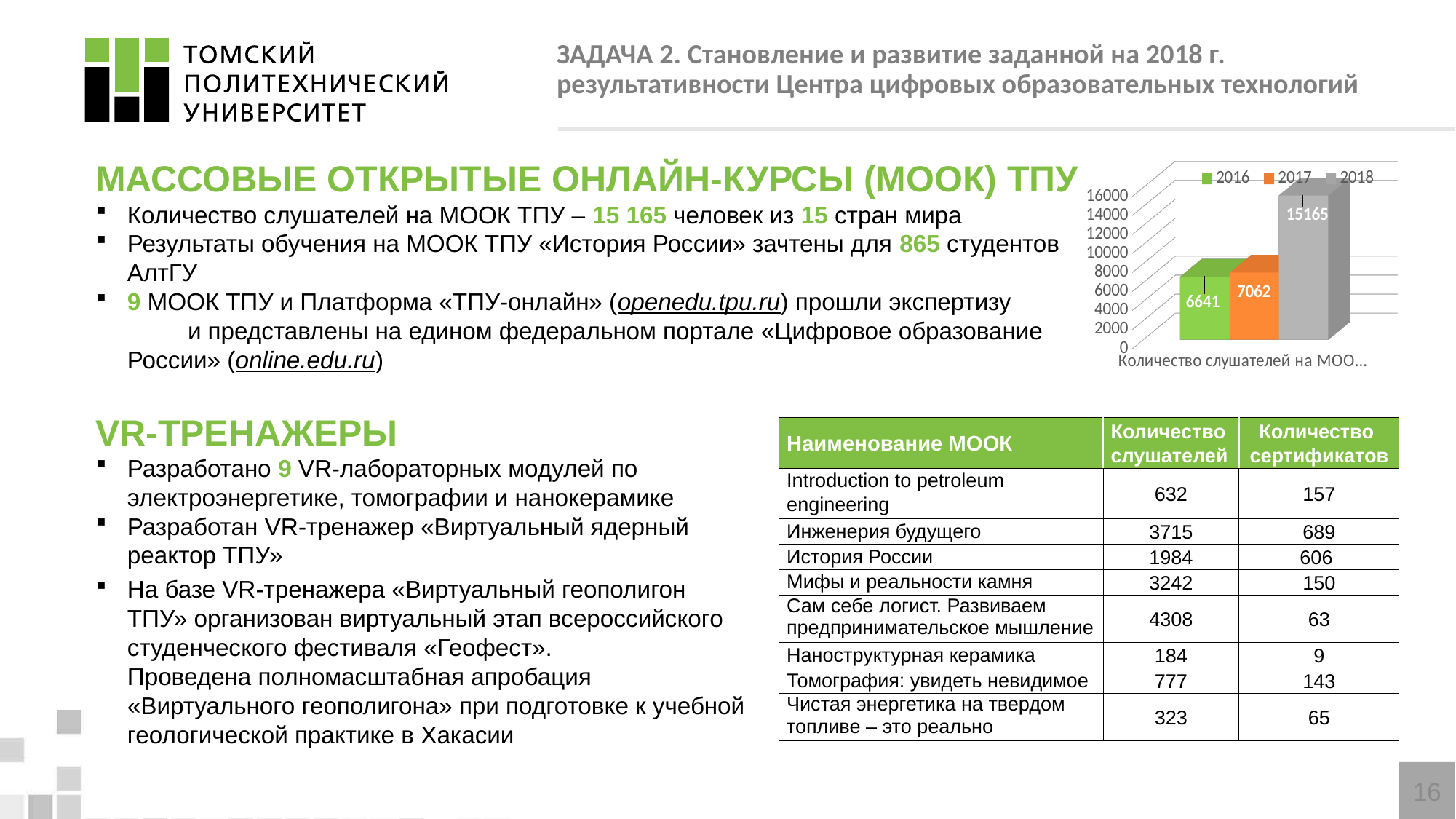
What is the difference between the 2018 and 2017 values in the chart? 8103 What kind of chart is shown on the slide? bar chart Which year has the highest value in the chart? 2018 How many series does the chart legend list? 3 What is the value for 2016 in the chart? 6641 What is the value for 2017 in the chart? 7062 Do the values in the chart rise or fall from 2016 to 2018? rise Which is larger in the chart, the value for 2016 or the value for 2018? 2018 What is the difference between the 2017 and 2016 values in the chart? 421 Is the value for 2018 in the chart greater or less than 14000? greater What is the value for 2018 in the chart? 15165 Which year has the lowest value in the chart? 2016